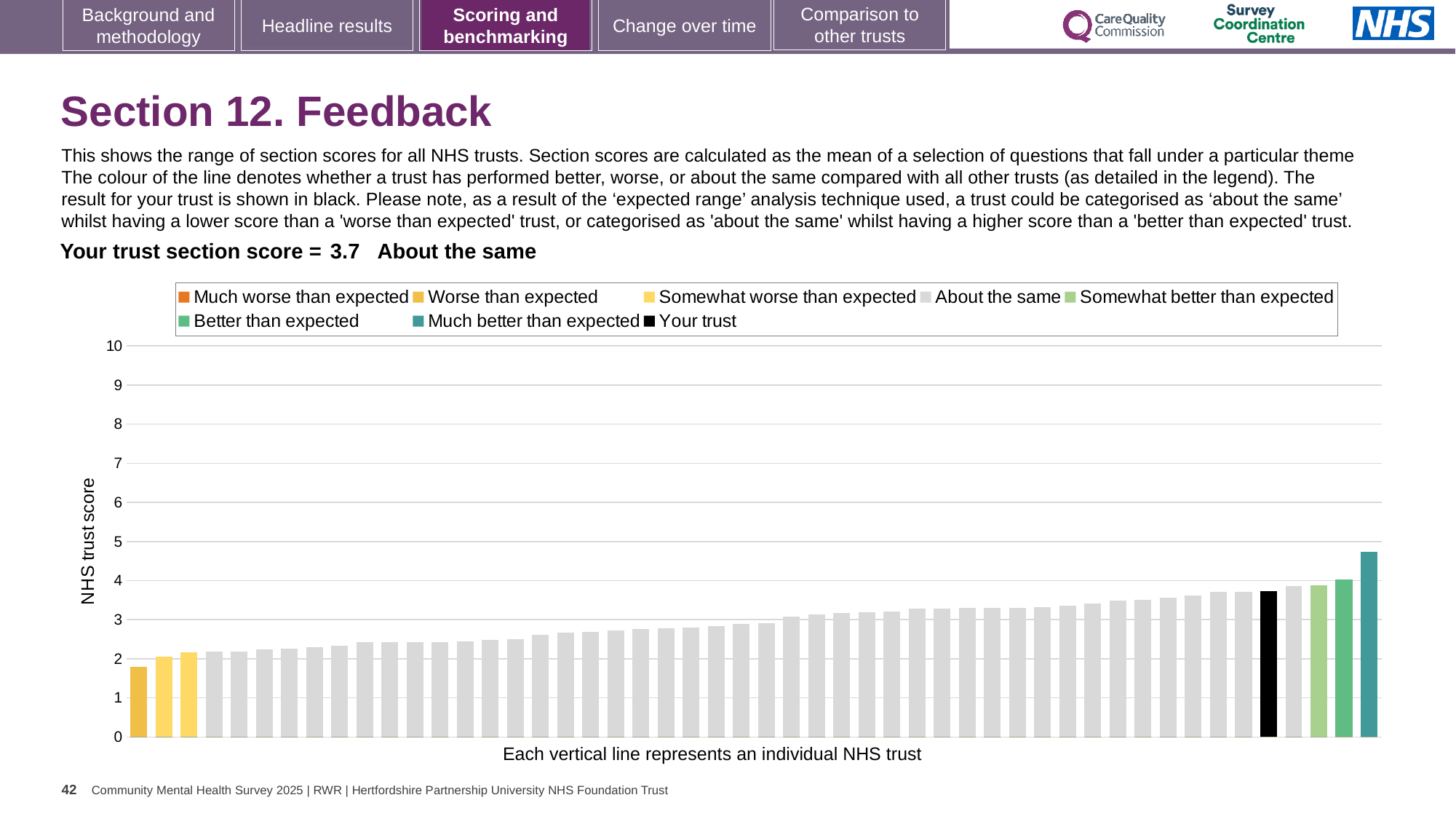
What is the title of the vertical axis? NHS trust score Do the bar values rise or fall from left to right along the x axis? rise Which legend category does the tallest bar belong to? Much better than expected Which is larger: the black 'Your trust' bar or the rightmost teal bar? The rightmost teal bar What kind of chart is shown on the slide? Bar chart Is the value of the tallest bar (the rightmost teal bar) greater or less than 4? greater What colour is used for the 'Your trust' bar? Black What is the section score for your trust shown on the slide? 3.7 Is the value of the black 'Your trust' bar greater or less than 3? greater Is the value of the leftmost bar greater or less than 2? less How many entries does the chart legend list? 8 Which category is your trust placed in for this section? About the same